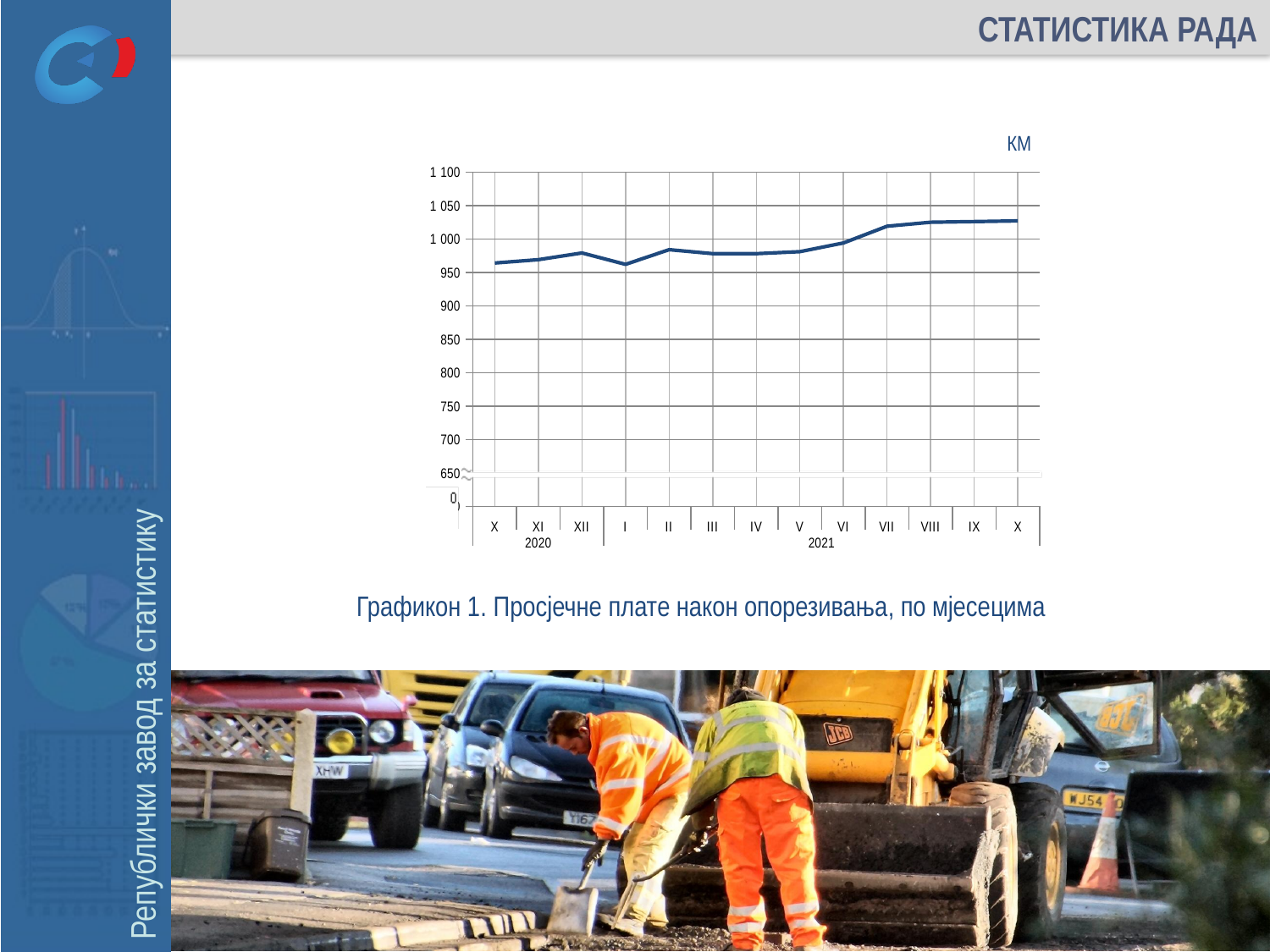
How many monthly data points are plotted on the chart? 13 Overall, do the values rise or fall from X 2020 to X 2021? rise Is the value for I 2021 greater or less than 1 000? less Which is larger, the value for X 2021 or the value for X 2020? X 2021 What is the title of the chart shown on the slide? Графикон 1. Просјечне плате након опорезивања, по мјесецима Is the value for X 2021 greater or less than 1 000? greater Which is larger, the value for I 2021 or the value for VIII 2021? VIII 2021 Is the value for VII 2021 greater or less than 1 000? greater What unit is indicated above the chart? KM What kind of chart is shown on the slide? line chart